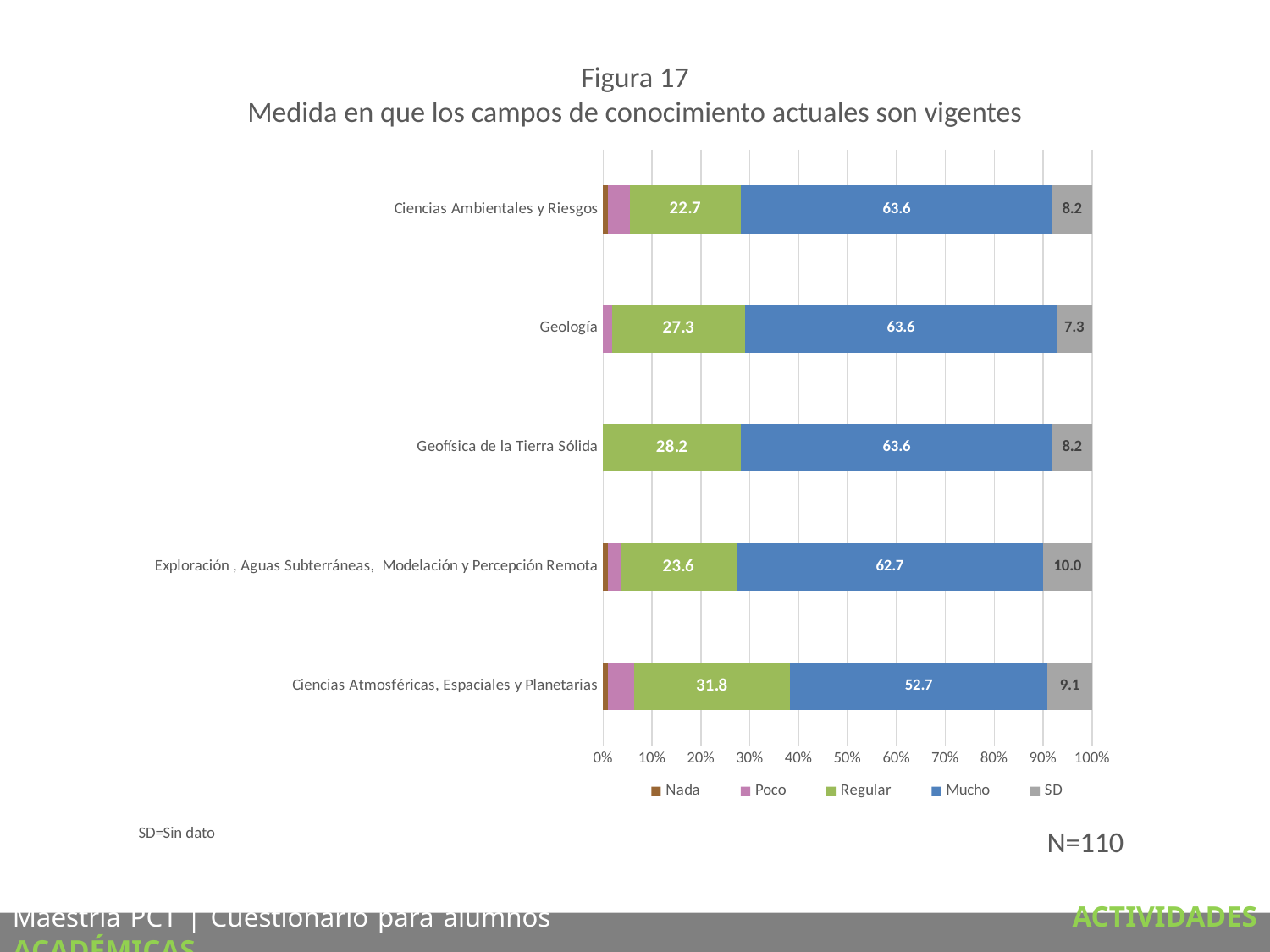
How many categories (fields of knowledge) are shown in the chart? 5 Which category has the lowest Mucho value? Ciencias Atmosféricas, Espaciales y Planetarias What is the value of the Mucho segment for Ciencias Atmosféricas, Espaciales y Planetarias? 52.7 What is the value of the Regular segment for Geología? 27.3 What is the difference between the Mucho and Regular values for Ciencias Ambientales y Riesgos? 40.9 What kind of chart is shown on the slide? Stacked bar chart What is the SD value for Exploración, Aguas Subterráneas, Modelación y Percepción Remota? 10.0 What is the Regular value for Geofísica de la Tierra Sólida? 28.2 Which category has the highest Regular value? Ciencias Atmosféricas, Espaciales y Planetarias How many series does the legend list? 5 Which category has the highest SD value? Exploración, Aguas Subterráneas, Modelación y Percepción Remota Which has a larger Regular value, Geología or Geofísica de la Tierra Sólida? Geofísica de la Tierra Sólida